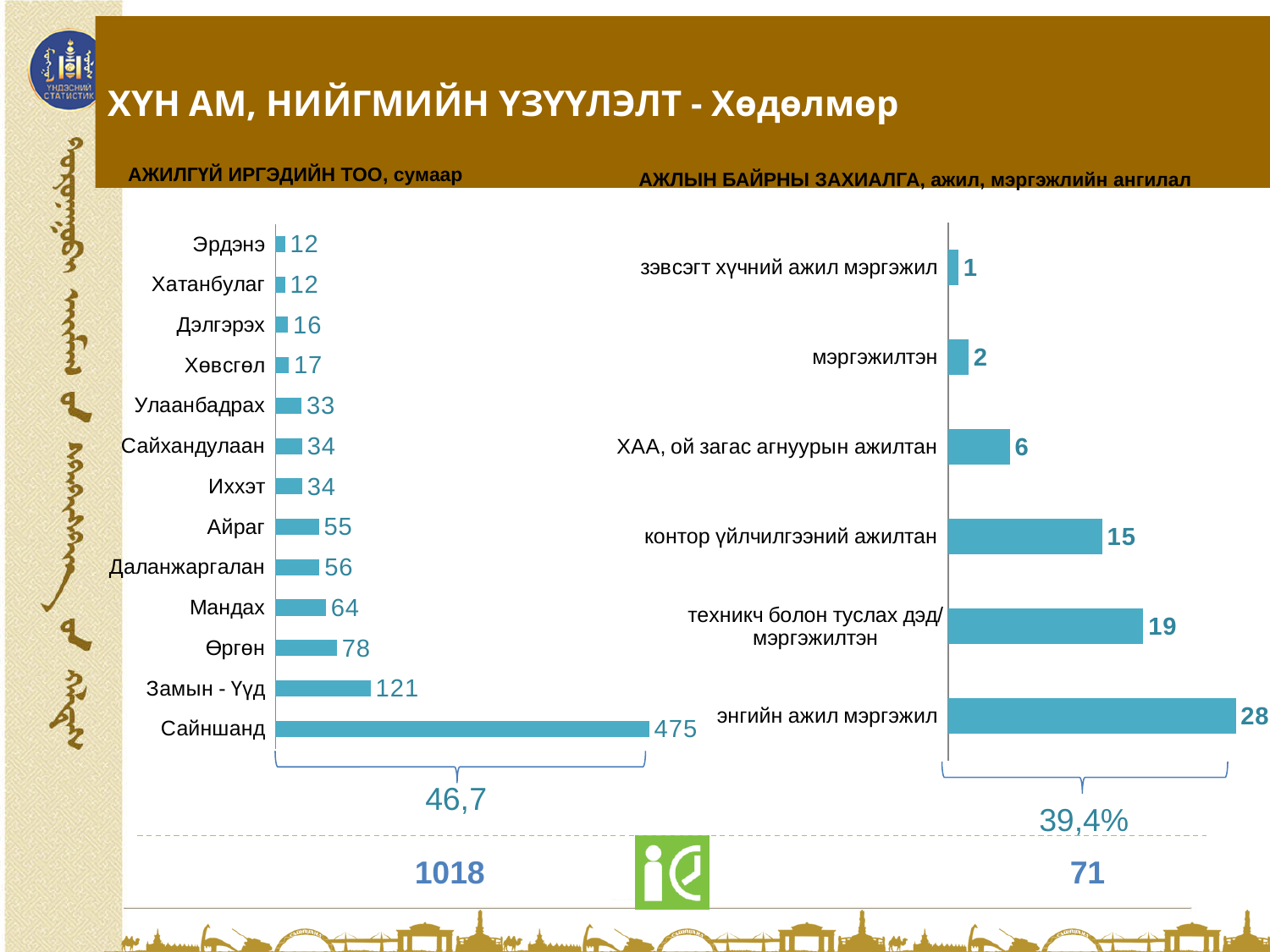
In the chart titled 'АЖЛЫН БАЙРНЫ ЗАХИАЛГА, ажил, мэргэжлийн ангилал', what is the value for контор үйлчилгээний ажилтан? 15 In the chart titled 'АЖИЛГҮЙ ИРГЭДИЙН ТОО, сумаар', what is the difference between the values for Сайншанд and Замын - Үүд? 354 In the chart titled 'АЖЛЫН БАЙРНЫ ЗАХИАЛГА, ажил, мэргэжлийн ангилал', which category has the lowest value? зэвсэгт хүчний ажил мэргэжил In the chart titled 'АЖИЛГҮЙ ИРГЭДИЙН ТОО, сумаар', which category has the highest value? Сайншанд In the chart titled 'АЖЛЫН БАЙРНЫ ЗАХИАЛГА, ажил, мэргэжлийн ангилал', what is the value for энгийн ажил мэргэжил? 28 In the chart titled 'АЖИЛГҮЙ ИРГЭДИЙН ТОО, сумаар', what is the value for Замын - Үүд? 121 In the chart titled 'АЖИЛГҮЙ ИРГЭДИЙН ТОО, сумаар', how many categories are plotted? 13 In the chart titled 'АЖИЛГҮЙ ИРГЭДИЙН ТОО, сумаар', which is larger, the value for Өргөн or the value for Мандах? Өргөн What kind of chart is the chart titled 'АЖИЛГҮЙ ИРГЭДИЙН ТОО, сумаар'? Bar chart In the chart titled 'АЖЛЫН БАЙРНЫ ЗАХИАЛГА, ажил, мэргэжлийн ангилал', what is the difference between the values for энгийн ажил мэргэжил and техникч болон туслах дэд/мэргэжилтэн? 9 In the chart titled 'АЖИЛГҮЙ ИРГЭДИЙН ТОО, сумаар', what is the value for Сайншанд? 475 In the chart titled 'АЖЛЫН БАЙРНЫ ЗАХИАЛГА, ажил, мэргэжлийн ангилал', how many categories are plotted? 6